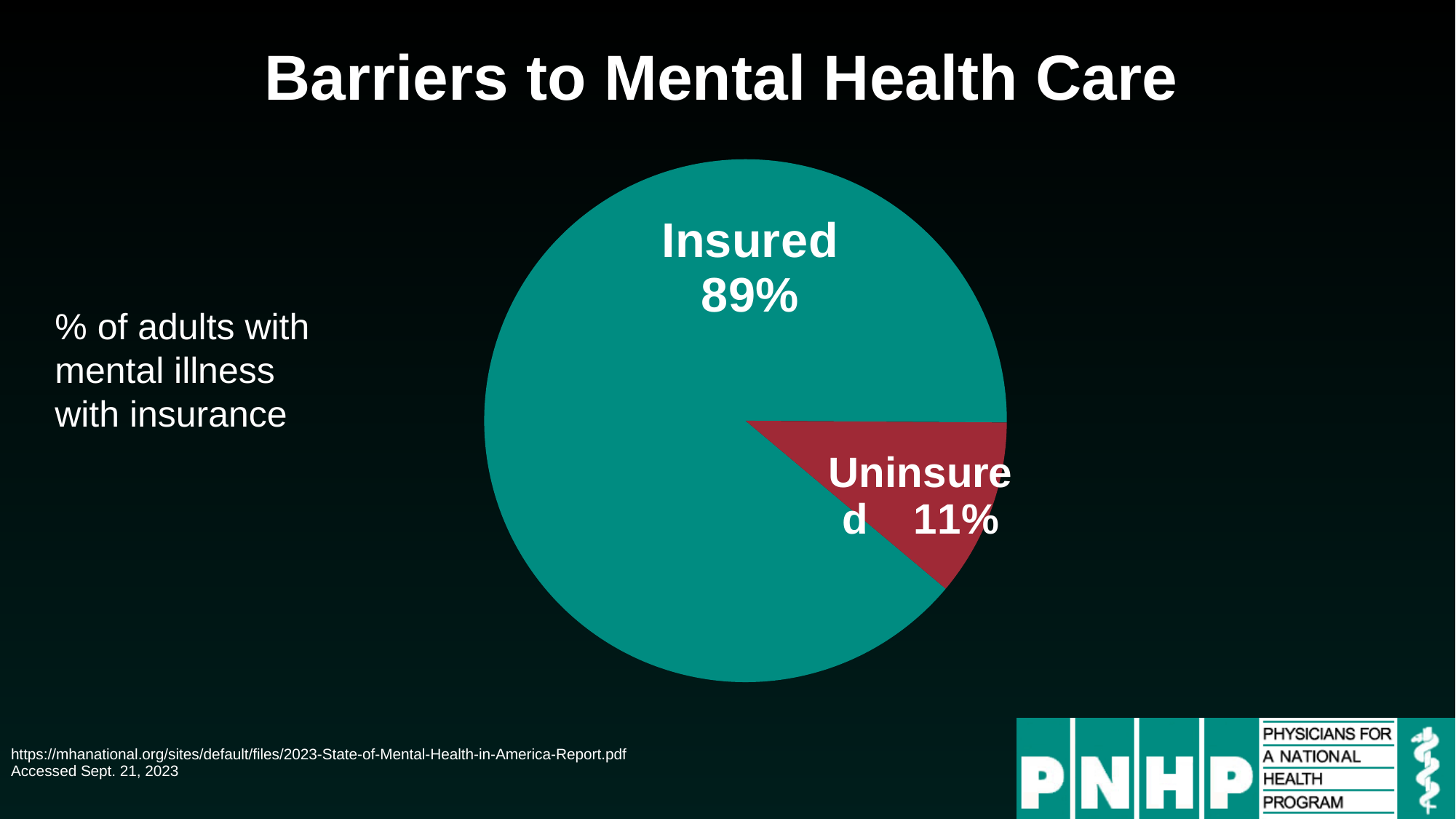
What share of the pie does the Uninsured slice represent? 11% How many slices does the pie chart have? 2 What percentage of adults with mental illness are insured according to the pie chart? 89% Which slice of the pie chart is the largest? Insured What colour is the Uninsured slice of the pie chart? red What percentage of adults with mental illness are uninsured according to the pie chart? 11% Which slice of the pie chart is the smallest? Uninsured Which is larger, the Insured slice or the Uninsured slice? Insured What is the difference in percentage points between the Insured and Uninsured slices? 78 What is the title of the slide containing the pie chart? Barriers to Mental Health Care What kind of chart is shown on the slide? pie chart